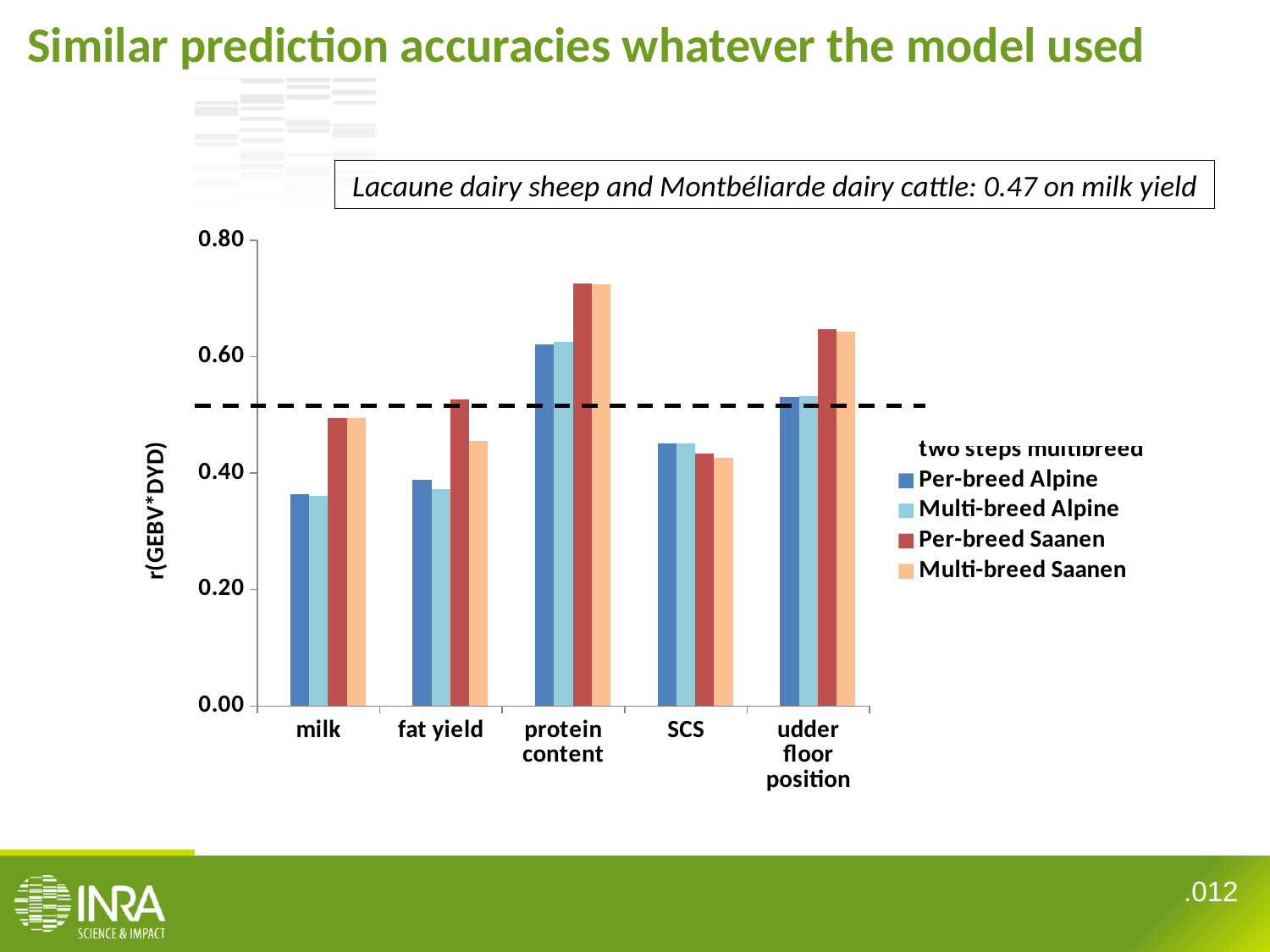
Is the Per-breed Saanen value for udder floor position greater or less than 0.60? greater How many trait categories are shown on the x axis of the chart? 5 What is the label of the vertical axis of the chart? r(GEBV*DYD) How many series does the chart's legend list? 5 For milk, which is larger: the Per-breed Alpine value or the Per-breed Saanen value? Per-breed Saanen Is the Per-breed Saanen value for protein content greater or less than 0.60? greater What kind of chart is shown on the slide? bar chart Is the Per-breed Saanen value for milk greater or less than 0.40? greater For fat yield, which is larger: the Per-breed Saanen value or the Multi-breed Saanen value? Per-breed Saanen Which trait has the lowest Per-breed Saanen value? SCS Which trait has the highest Per-breed Saanen value? protein content